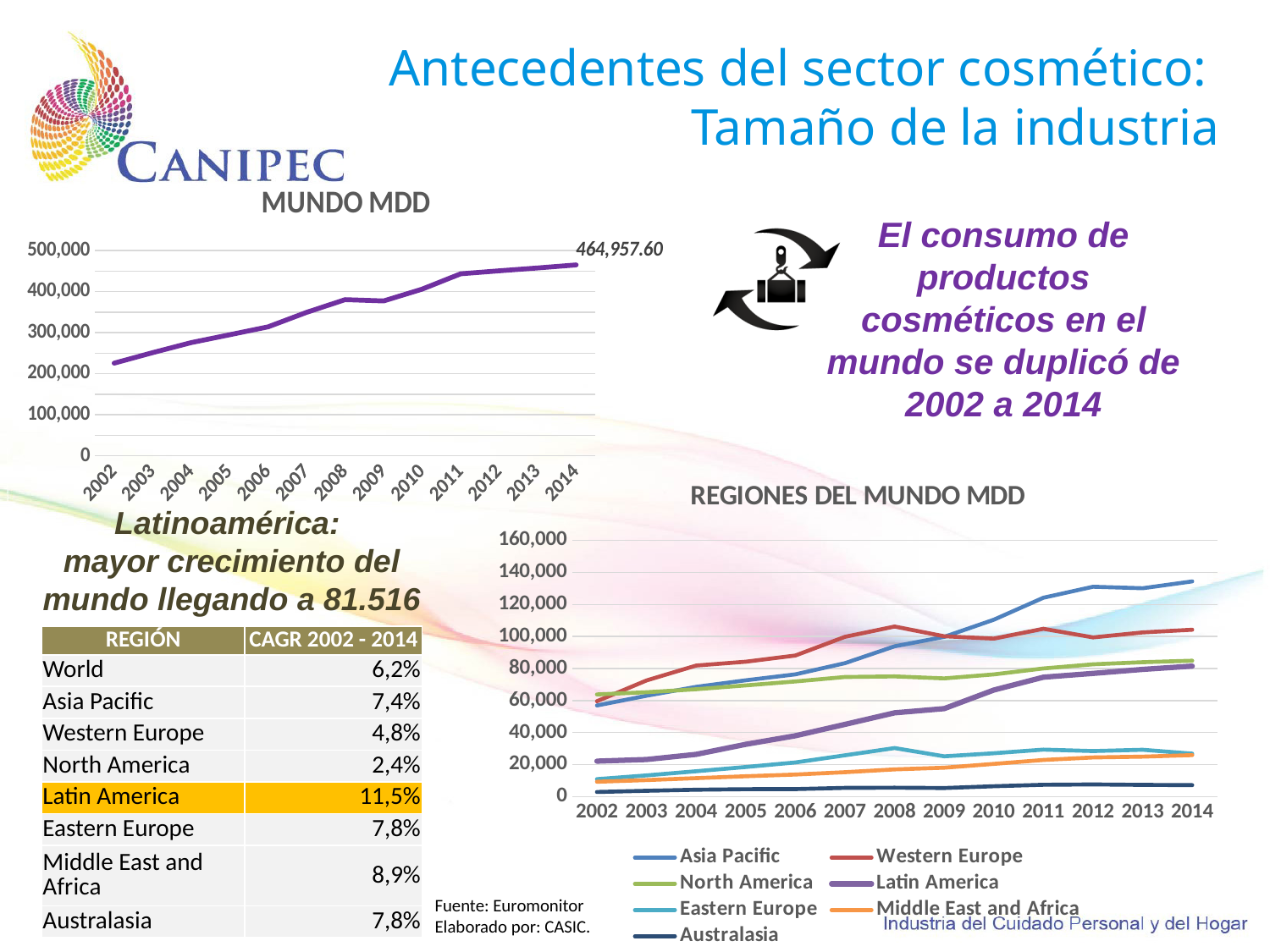
What kind of chart is the 'MUNDO MDD' chart? line chart How many years are plotted on the x axis of the 'MUNDO MDD' chart? 13 In the 'MUNDO MDD' chart, is the value for 2008 greater or less than 300,000? greater In the 'MUNDO MDD' chart, is the value for 2002 greater or less than 300,000? less In the 'REGIONES DEL MUNDO MDD' chart, does the Asia Pacific line rise or fall from 2002 to 2014? rise In the 'MUNDO MDD' chart, what value is labelled for 2014? 464,957.60 In the 'REGIONES DEL MUNDO MDD' chart, which is larger in 2014: Western Europe or North America? Western Europe In the 'REGIONES DEL MUNDO MDD' chart, which region has the lowest value in 2014? Australasia In the 'REGIONES DEL MUNDO MDD' chart, which region has the highest value in 2014? Asia Pacific In the 'MUNDO MDD' chart, do the values rise or fall from 2002 to 2014? rise How many series does the legend of the 'REGIONES DEL MUNDO MDD' chart list? 7 In the 'REGIONES DEL MUNDO MDD' chart, is the value for Latin America in 2014 greater or less than 60,000? greater